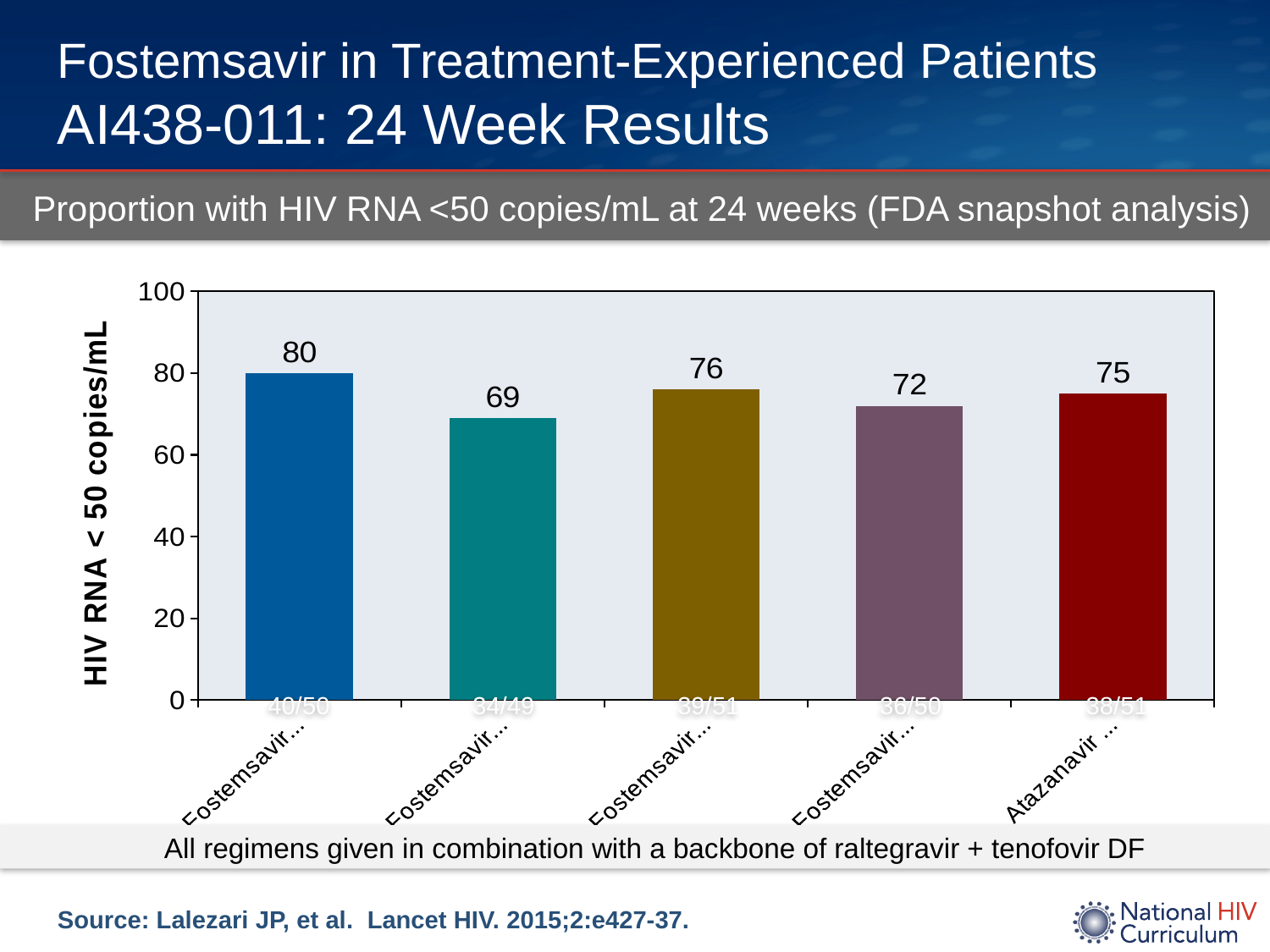
Which bar has the highest value? the leftmost (first) bar, 80 What type of chart is shown on the slide? bar chart What is the value shown on the second bar from the left? 69 What is the difference between the highest bar value (80) and the lowest bar value (69)? 11 What is the value shown on the leftmost (first) bar? 80 What is the value shown on the rightmost bar, labelled Atazanavir? 75 What is the label on the y-axis of the chart? HIV RNA < 50 copies/mL Which is larger, the value of the third bar or the value of the fourth bar? the third bar (76) Which bar has the lowest value? the second bar from the left, 69 How many bars are plotted in the chart? 5 Is the value of the fourth bar from the left greater or less than 80? less What is the value shown on the middle (third) bar? 76